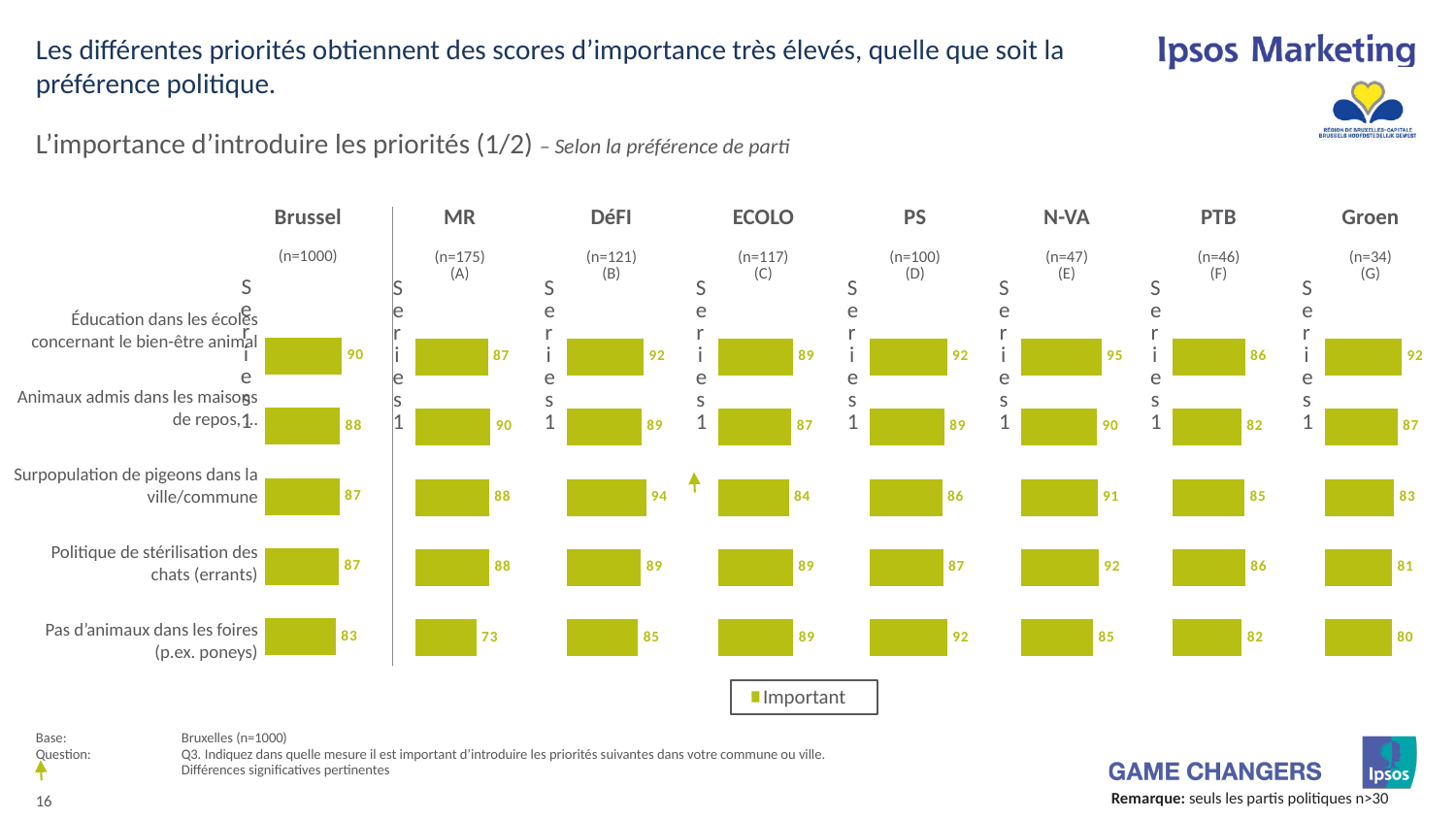
What is the legend entry shown below the charts? Important In the MR chart, what is the value for "Pas d'animaux dans les foires (p.ex. poneys)"? 73 In the DéFI chart, what is the difference between "Surpopulation de pigeons dans la ville/commune" and "Pas d'animaux dans les foires (p.ex. poneys)"? 9 How many series does the legend list? 1 In the N-VA chart, which category has the highest value? Éducation dans les écoles concernant le bien-être animal In the MR chart, which category has the lowest value? Pas d'animaux dans les foires (p.ex. poneys) How many categories are shown in the ECOLO chart? 5 In the Brussel chart, what is the value for "Éducation dans les écoles concernant le bien-être animal"? 90 What kind of chart is used for the Brussel data? Bar chart In the PTB chart, which is larger: "Éducation dans les écoles concernant le bien-être animal" or "Animaux admis dans les maisons de repos"? Éducation dans les écoles concernant le bien-être animal In the PS chart, what is the value for "Surpopulation de pigeons dans la ville/commune"? 86 In the Groen chart, which category has the lowest value? Pas d'animaux dans les foires (p.ex. poneys)